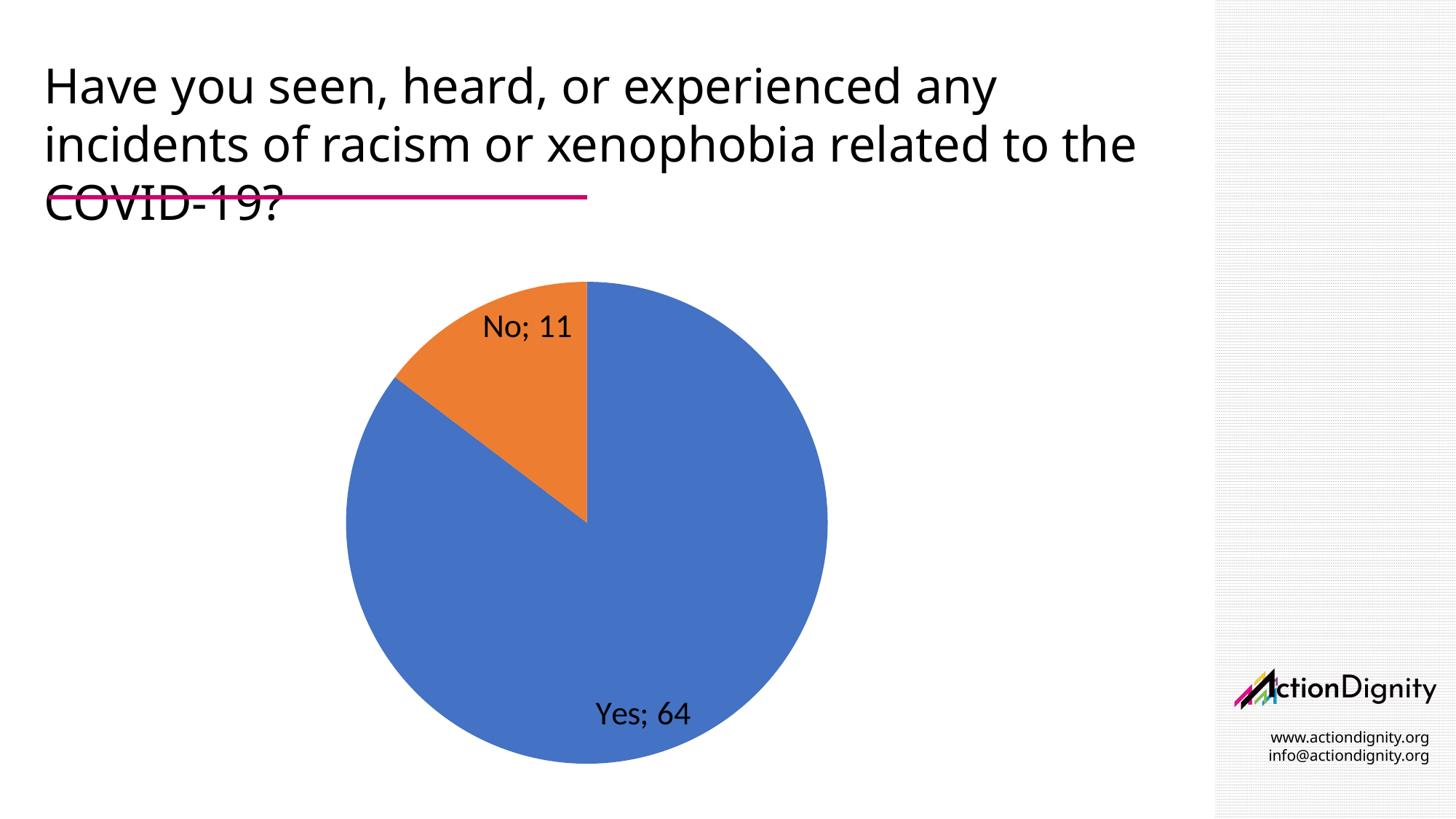
What colour is the No slice? orange What is the value for No? 11 What is the difference between the Yes and No values? 53 What is the total of all slices in the pie chart? 75 What kind of chart is shown on the slide? pie chart Which is larger, Yes or No? Yes How many slices does the pie chart have? 2 Which category has the smallest slice? No What colour is the Yes slice? blue What is the value for Yes? 64 Which category has the largest slice? Yes